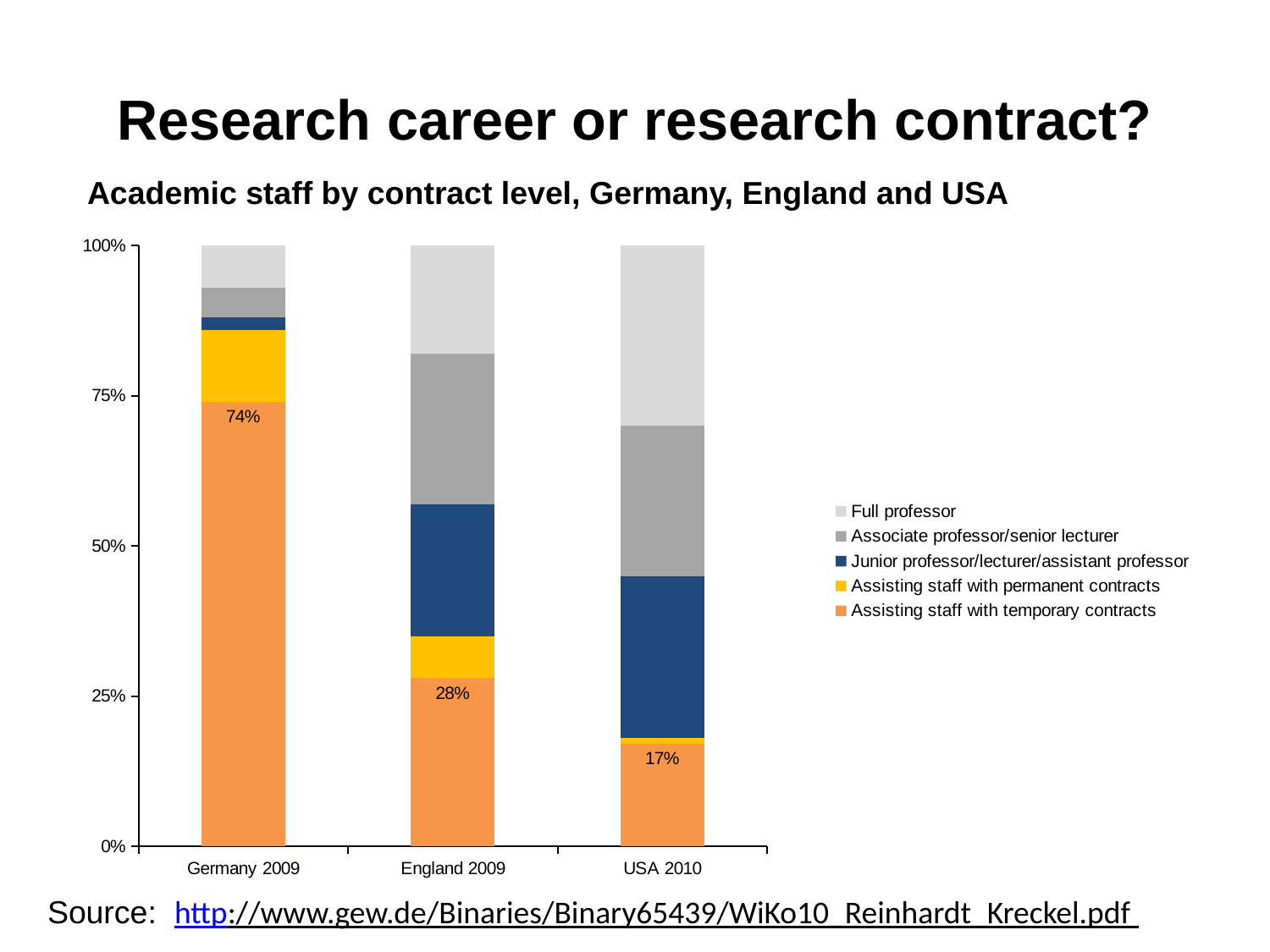
What is the value for Assisting staff with temporary contracts for USA 2010? 17% What is the value for Assisting staff with temporary contracts for Germany 2009? 74% Which category has the lowest share of Assisting staff with temporary contracts? USA 2010 Is the value for Full professor in Germany 2009 greater or less than 25%? less How many categories are shown on the x axis? 3 Which is larger, the Assisting staff with temporary contracts value for England 2009 or for USA 2010? England 2009 Which category has the highest share of Assisting staff with temporary contracts? Germany 2009 What is the value for Assisting staff with temporary contracts for England 2009? 28% How many series does the legend list? 5 What kind of chart is shown on the slide? Stacked bar chart What is the difference between the Assisting staff with temporary contracts values for Germany 2009 and England 2009? 46 percentage points Does the share of Assisting staff with temporary contracts rise or fall from Germany 2009 to USA 2010? Fall